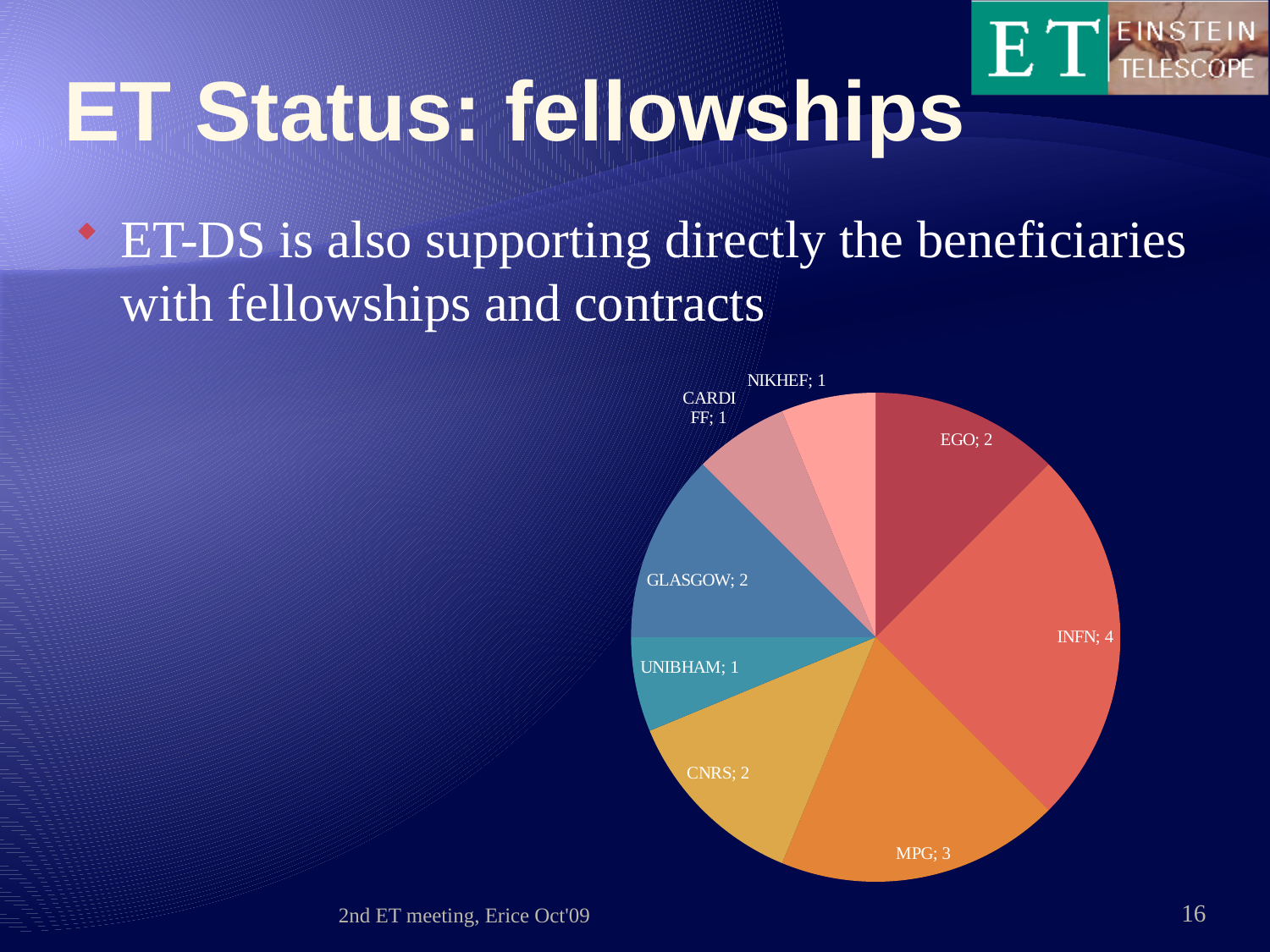
How many fellowships does the pie chart show for INFN? 4 What share of the pie does the INFN slice represent? 25% What value is shown for UNIBHAM in the pie chart? 1 What value is shown for MPG in the pie chart? 3 What is the total of all the values shown in the pie chart? 16 Which beneficiary has the largest slice in the pie chart? INFN What is the difference between the values for INFN and CNRS? 2 What kind of chart is shown on the slide? Pie chart What is the difference between the values for EGO and NIKHEF? 1 Which is larger in the pie chart, the value for MPG or the value for GLASGOW? MPG How many slices does the pie chart have? 8 Which beneficiaries in the pie chart have a value of 1? UNIBHAM, CARDIFF, NIKHEF